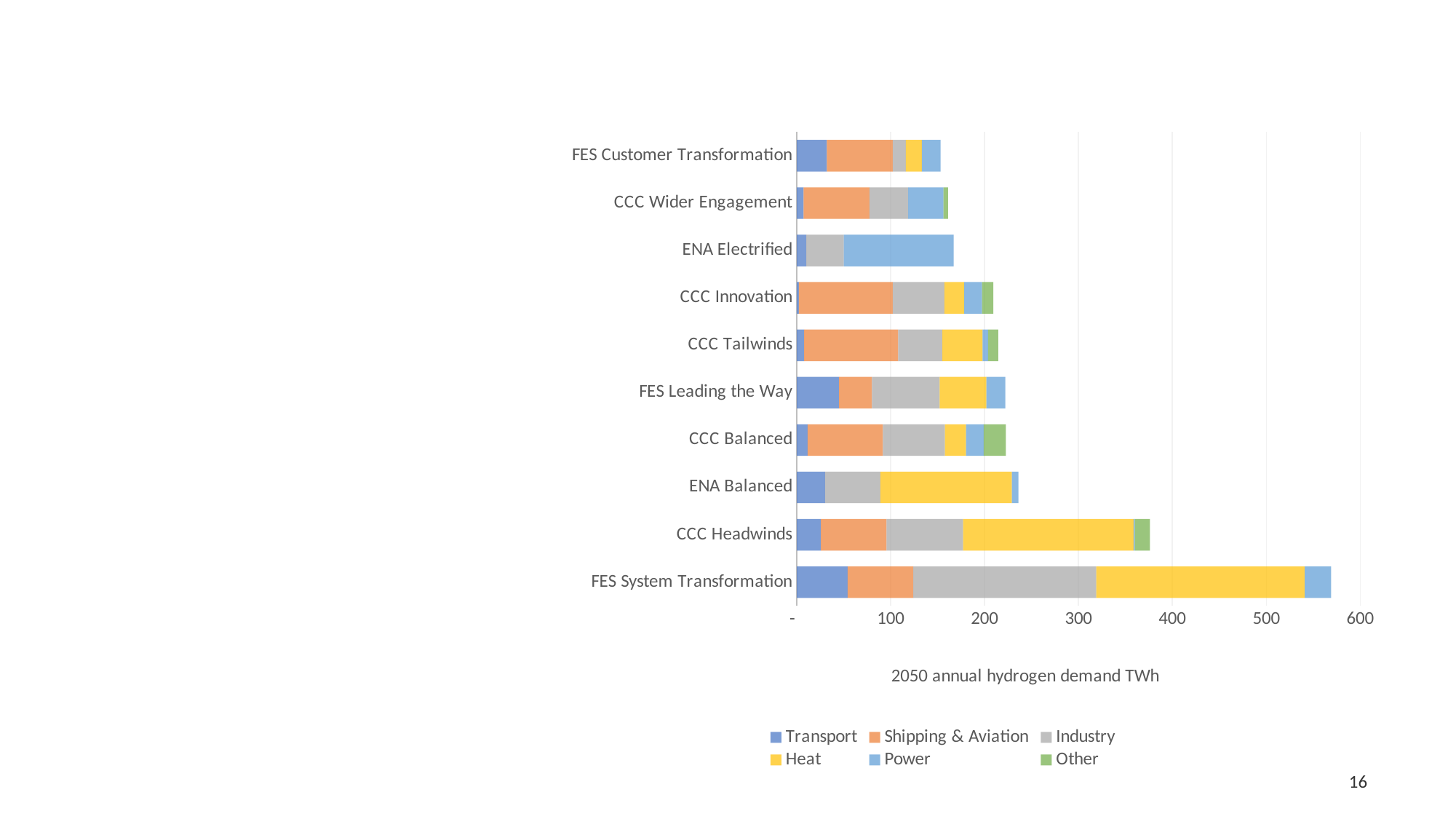
How many series does the legend list? 6 What kind of chart is shown on the slide? Stacked bar chart Which series is shown in yellow in the legend? Heat How many scenarios (categories) are plotted on the chart? 10 Which scenario has the highest total 2050 annual hydrogen demand? FES System Transformation What is the title of the horizontal axis? 2050 annual hydrogen demand TWh Is the total value for FES System Transformation greater or less than 500? greater Is the total value for CCC Headwinds greater or less than 300? greater Is the total value for ENA Electrified greater or less than 200? less Which has the larger total: FES System Transformation or CCC Headwinds? FES System Transformation Which has the larger total: CCC Headwinds or ENA Balanced? CCC Headwinds